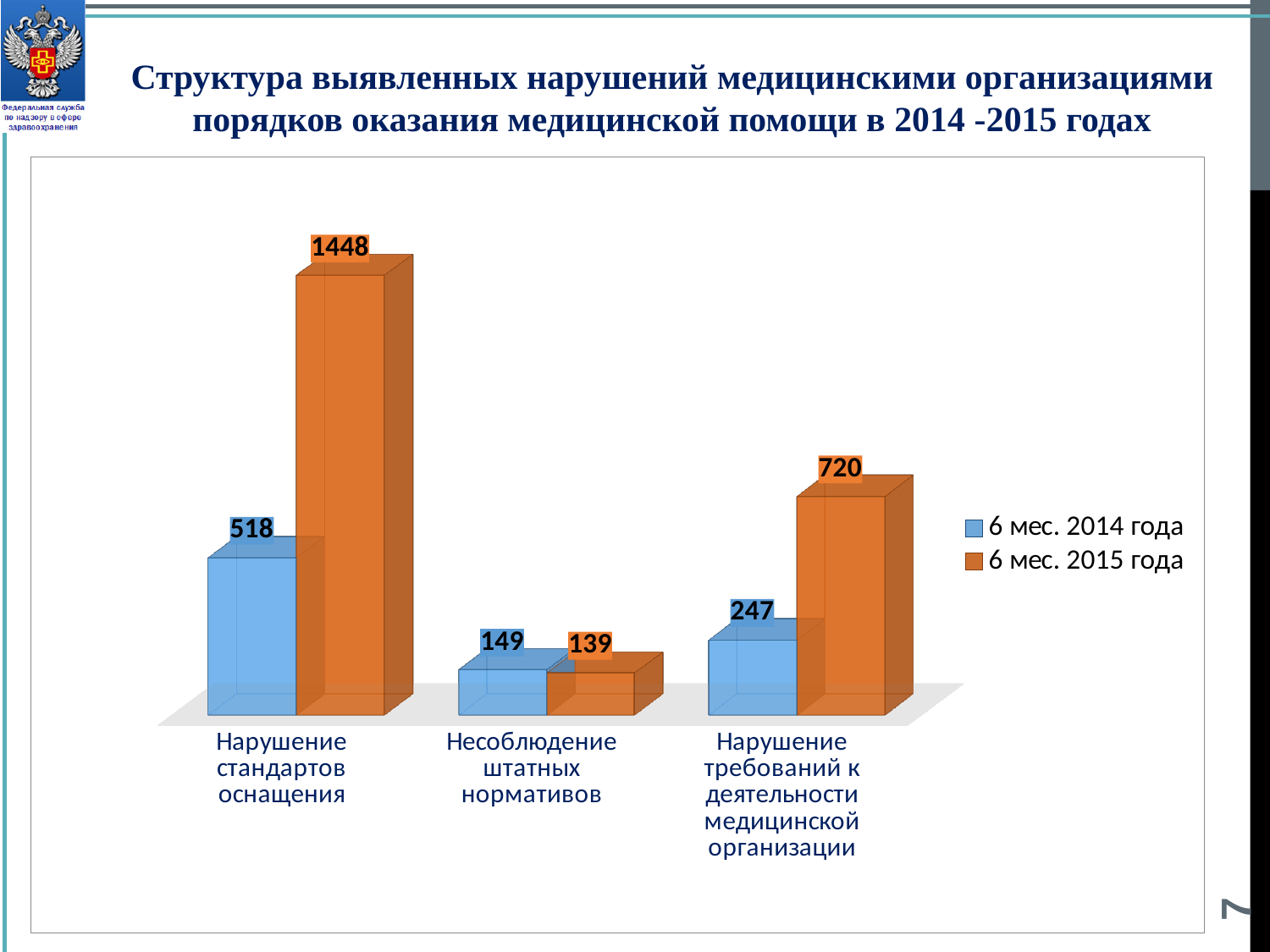
Which colour represents the "6 мес. 2015 года" series? Orange What is the value for "Несоблюдение штатных нормативов" in the "6 мес. 2014 года" series? 149 Which category has the highest value in the "6 мес. 2014 года" series? Нарушение стандартов оснащения How many categories are shown on the x axis? 3 What is the value for "Нарушение стандартов оснащения" in the "6 мес. 2015 года" series? 1448 What is the value for "Нарушение требований к деятельности медицинской организации" in the "6 мес. 2015 года" series? 720 What is the difference between the 2015 and 2014 values for "Нарушение стандартов оснащения"? 930 What is the difference between the 2014 and 2015 values for "Несоблюдение штатных нормативов"? 10 What kind of chart is shown on the slide? Bar chart For "Нарушение требований к деятельности медицинской организации", which series has the larger value: "6 мес. 2014 года" or "6 мес. 2015 года"? 6 мес. 2015 года How many series does the legend list? 2 Which category has the lowest value in the "6 мес. 2015 года" series? Несоблюдение штатных нормативов